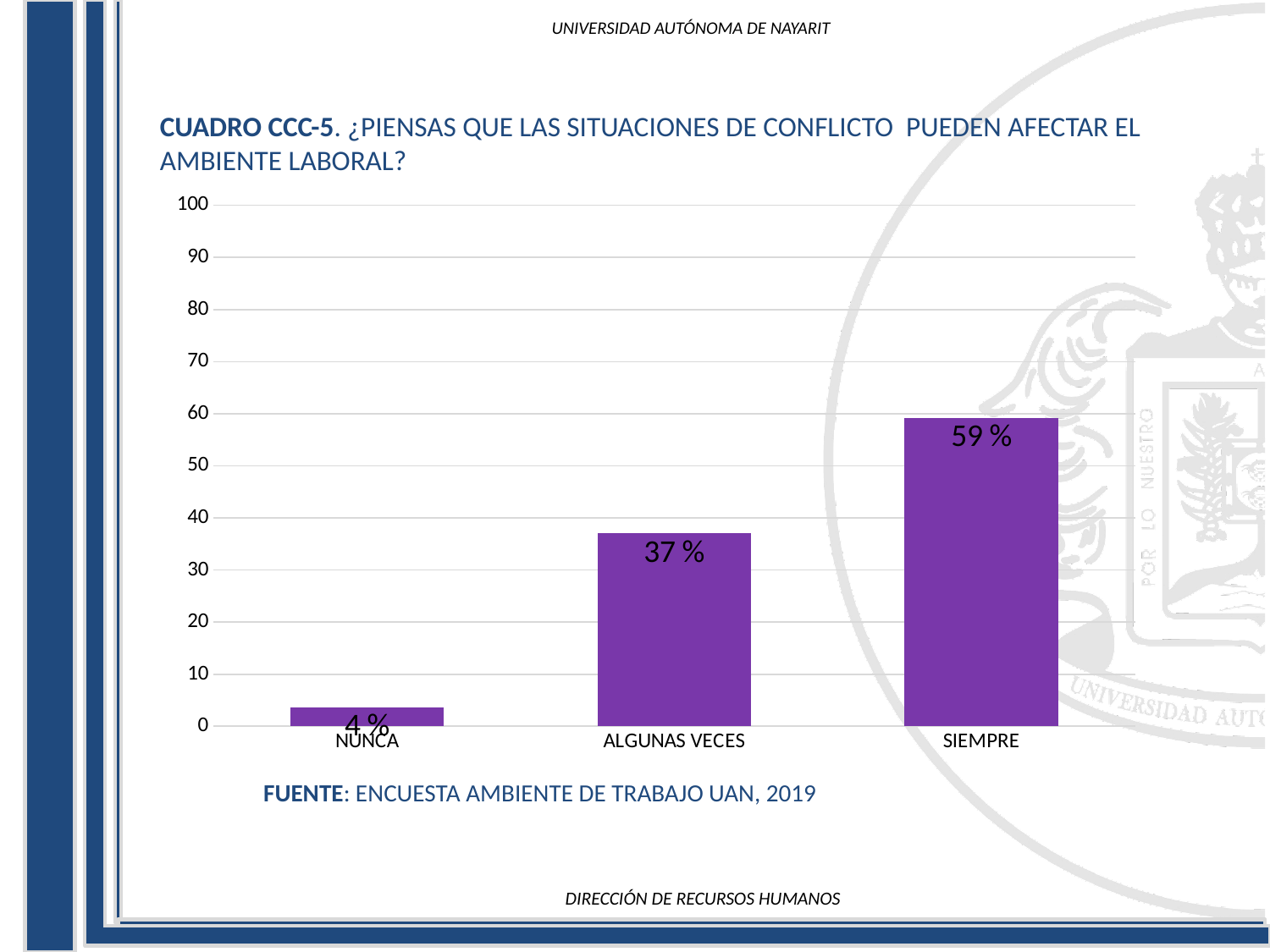
Which category has the lowest value? NUNCA How many categories are shown on the x axis? 3 What is the difference between the values for SIEMPRE and ALGUNAS VECES? 22 % What is the value for NUNCA? 4 % Which is larger, the value for ALGUNAS VECES or the value for NUNCA? ALGUNAS VECES What kind of chart is shown on the slide? bar chart What source is cited below the chart? ENCUESTA AMBIENTE DE TRABAJO UAN, 2019 What is the value for ALGUNAS VECES? 37 % What is the value for SIEMPRE? 59 % Which category has the highest value? SIEMPRE Is the value for ALGUNAS VECES greater or less than 40? less Do the values rise or fall from NUNCA to SIEMPRE along the x axis? rise